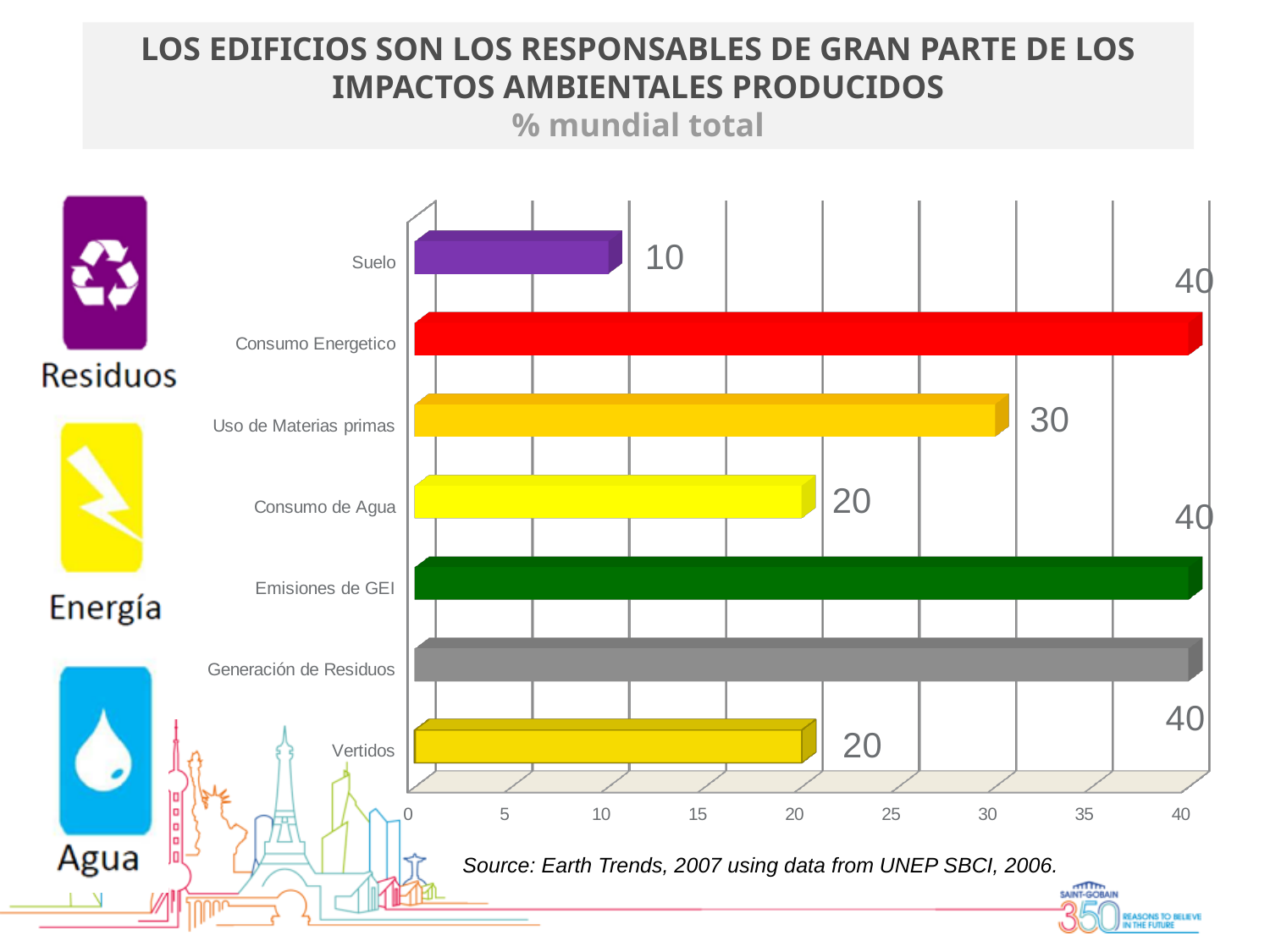
What is the value for Suelo? 10 What is the value for Consumo Energetico? 40 Which category has the lowest value? Suelo What is the difference between the values for Consumo Energetico and Uso de Materias primas? 10 What is the value for Uso de Materias primas? 30 What is the value for Consumo de Agua? 20 What kind of chart is shown on the slide? bar chart What is the value for Vertidos? 20 How many categories are shown in the chart? 7 Is the value for Emisiones de GEI greater or less than 25? greater What is the difference between the values for Consumo de Agua and Suelo? 10 Which is larger, the value for Uso de Materias primas or the value for Vertidos? Uso de Materias primas